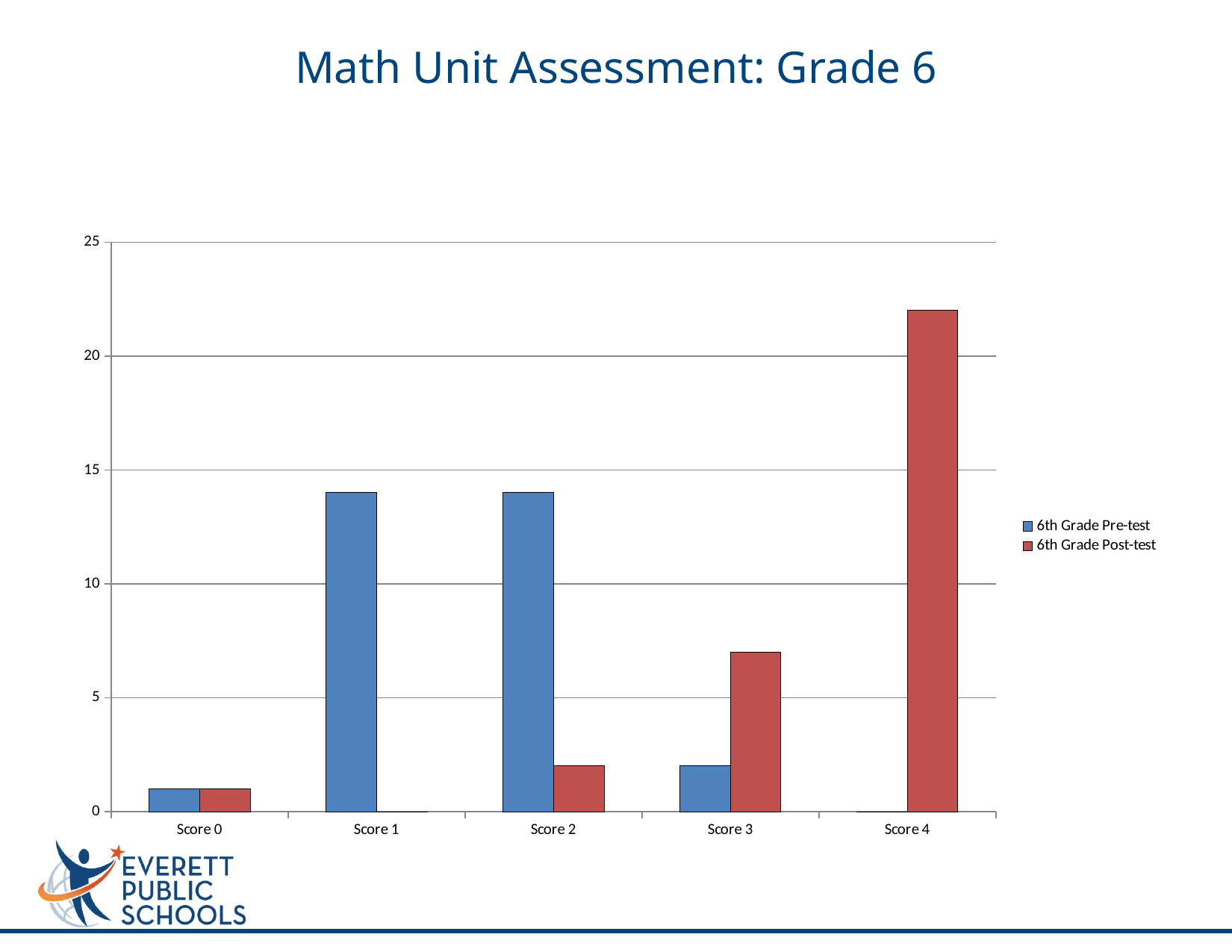
What is the title of the chart? Math Unit Assessment: Grade 6 What kind of chart is shown on the slide? bar chart Which score category has the highest 6th Grade Post-test value? Score 4 How many score categories are shown on the x axis? 5 For Score 3, which is larger: the 6th Grade Pre-test value or the 6th Grade Post-test value? 6th Grade Post-test Which series is shown in red? 6th Grade Post-test For Score 2, which is larger: the 6th Grade Pre-test value or the 6th Grade Post-test value? 6th Grade Pre-test How many series does the legend list? 2 Is the 6th Grade Post-test value for Score 3 greater or less than 5? greater Is the 6th Grade Post-test value for Score 4 greater or less than 20? greater Which score category has the lowest 6th Grade Post-test value? Score 1 Is the 6th Grade Pre-test value for Score 1 greater or less than 15? less